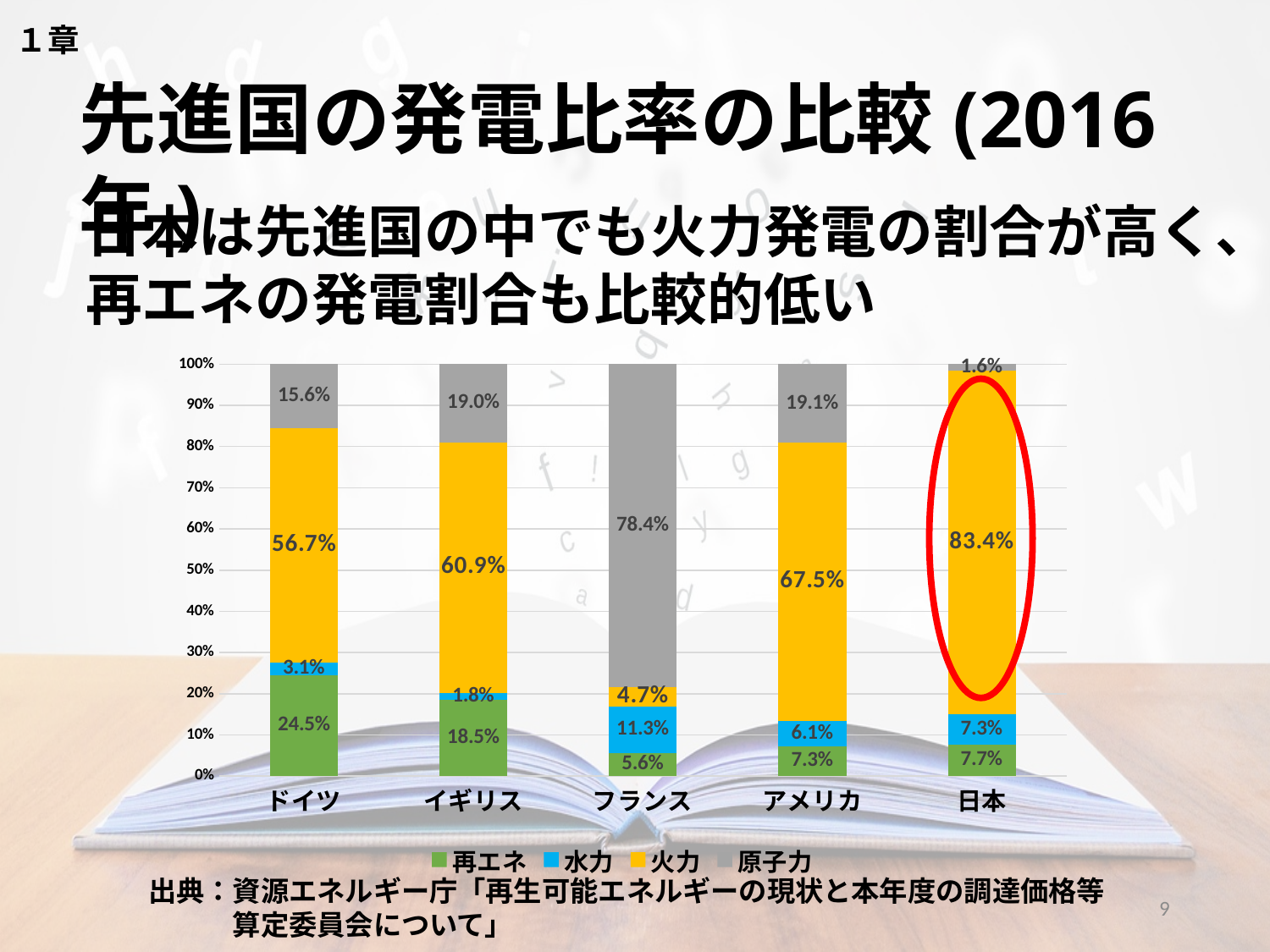
Which series is shown in yellow in the chart legend? 火力 What is the 再エネ share for ドイツ? 24.5% What is the difference between the 火力 share of 日本 and that of ドイツ? 26.7% What is the 水力 share for アメリカ? 6.1% What is the 火力 share for 日本? 83.4% What type of chart is shown on the slide? Stacked bar chart How many series does the chart legend list? 4 Which is larger, the 再エネ share of イギリス or that of アメリカ? イギリス How many countries are shown on the x axis of the chart? 5 Which country has the lowest 原子力 share? 日本 What is the 原子力 share for フランス? 78.4% Which country has the highest 火力 share? 日本